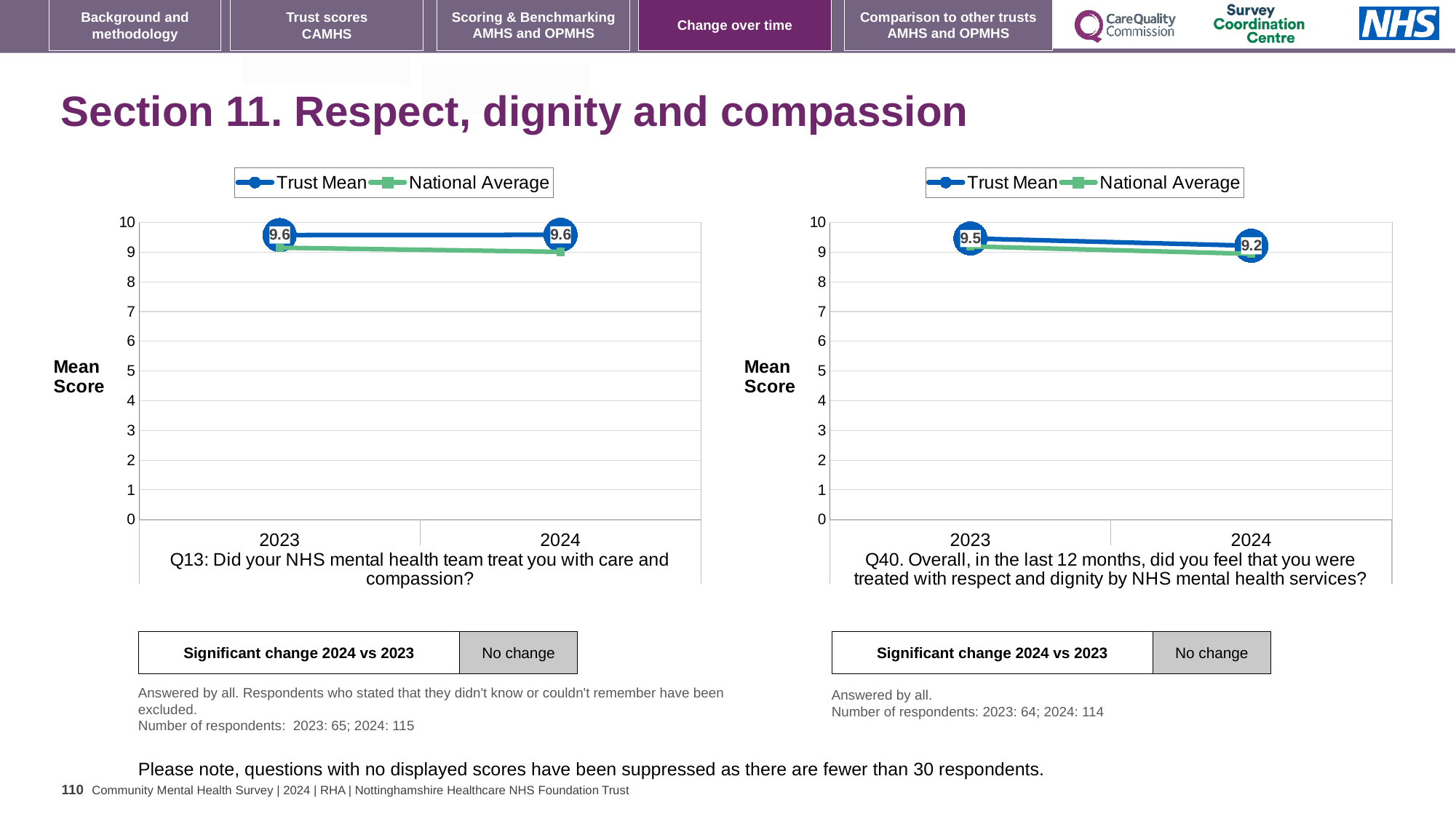
In the left chart (Q13), which series has the higher value in 2023, Trust Mean or National Average? Trust Mean In the left chart (Q13), is the National Average value for 2024 greater or less than 8? greater What kind of chart is the left chart (Q13)? line chart In the left chart (Q13), what is the Trust Mean value for 2024? 9.6 How many years are plotted on the x axis of the left chart (Q13)? 2 In the right chart (Q40), by how much did the Trust Mean change from 2023 to 2024? 0.3 In the right chart (Q40), which year has the higher Trust Mean, 2023 or 2024? 2023 In the right chart (Q40), does the Trust Mean rise or fall from 2023 to 2024? fall How many series does the legend of the right chart (Q40) list? 2 In the right chart (Q40), what is the Trust Mean value for 2024? 9.2 In the right chart (Q40), what is the Trust Mean value for 2023? 9.5 In the left chart (Q13), what is the Trust Mean value for 2023? 9.6